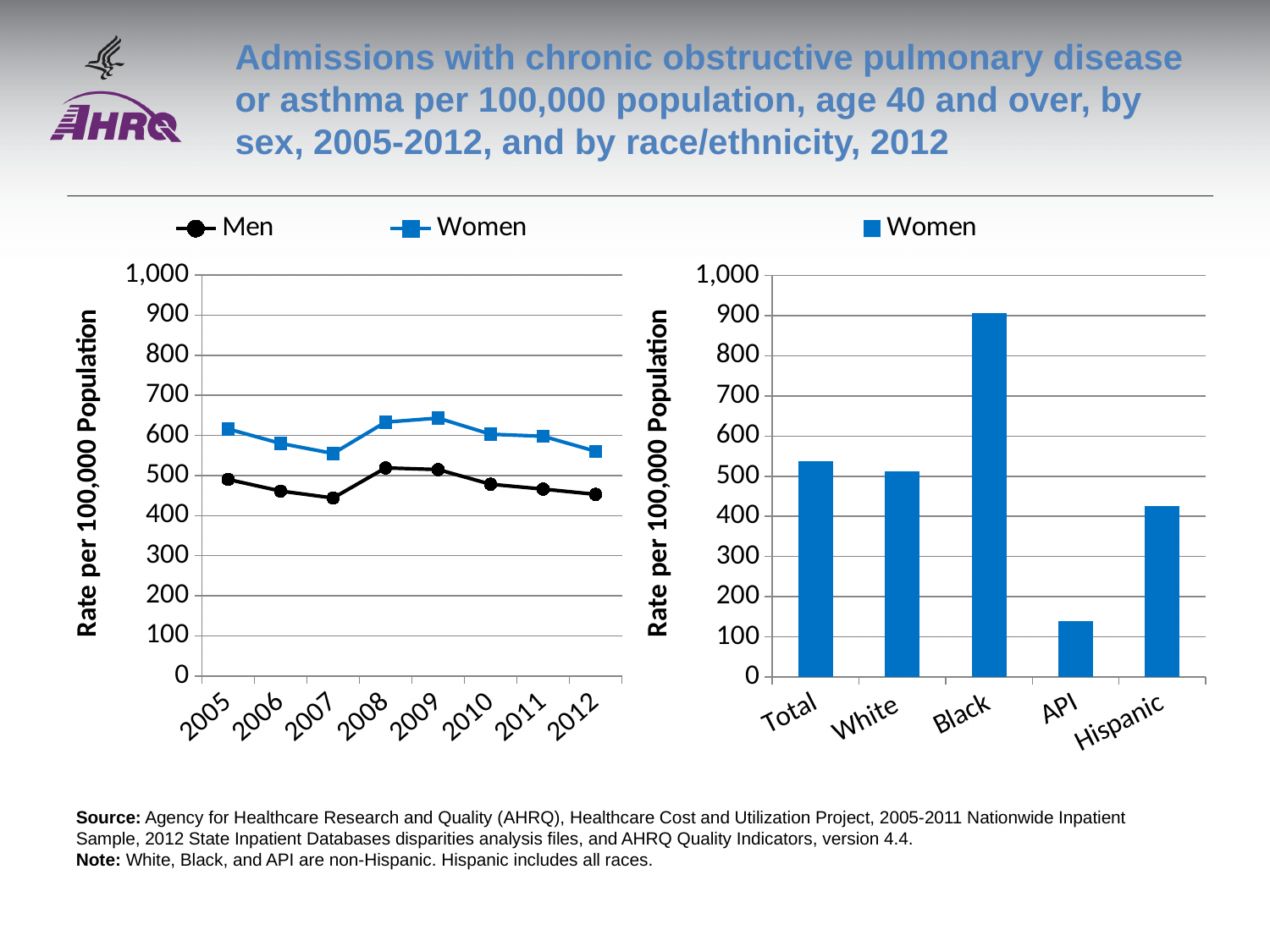
In the left chart (by sex, 2005-2012), how many series does the legend list? 2 In the right chart (by race/ethnicity, 2012), which category has the highest rate? Black In the left chart (by sex, 2005-2012), does the rate for Men rise or fall from 2009 to 2012? fall In the right chart (by race/ethnicity, 2012), is the value for Black greater or less than 800? greater In the right chart (by race/ethnicity, 2012), which is larger, the rate for White or the rate for Hispanic? White In the right chart (by race/ethnicity, 2012), how many race/ethnicity categories are shown? 5 In the right chart (by race/ethnicity, 2012), which category has the lowest rate? API What kind of chart is the left chart showing rates by sex, 2005-2012? line chart In the left chart (by sex, 2005-2012), how many years are plotted on the x axis? 8 What kind of chart is the right chart showing rates by race/ethnicity, 2012? bar chart In the left chart (by sex, 2005-2012), is the value for Women in 2009 greater or less than 600? greater In the left chart (by sex, 2005-2012), which series has the higher rate in 2012, Men or Women? Women